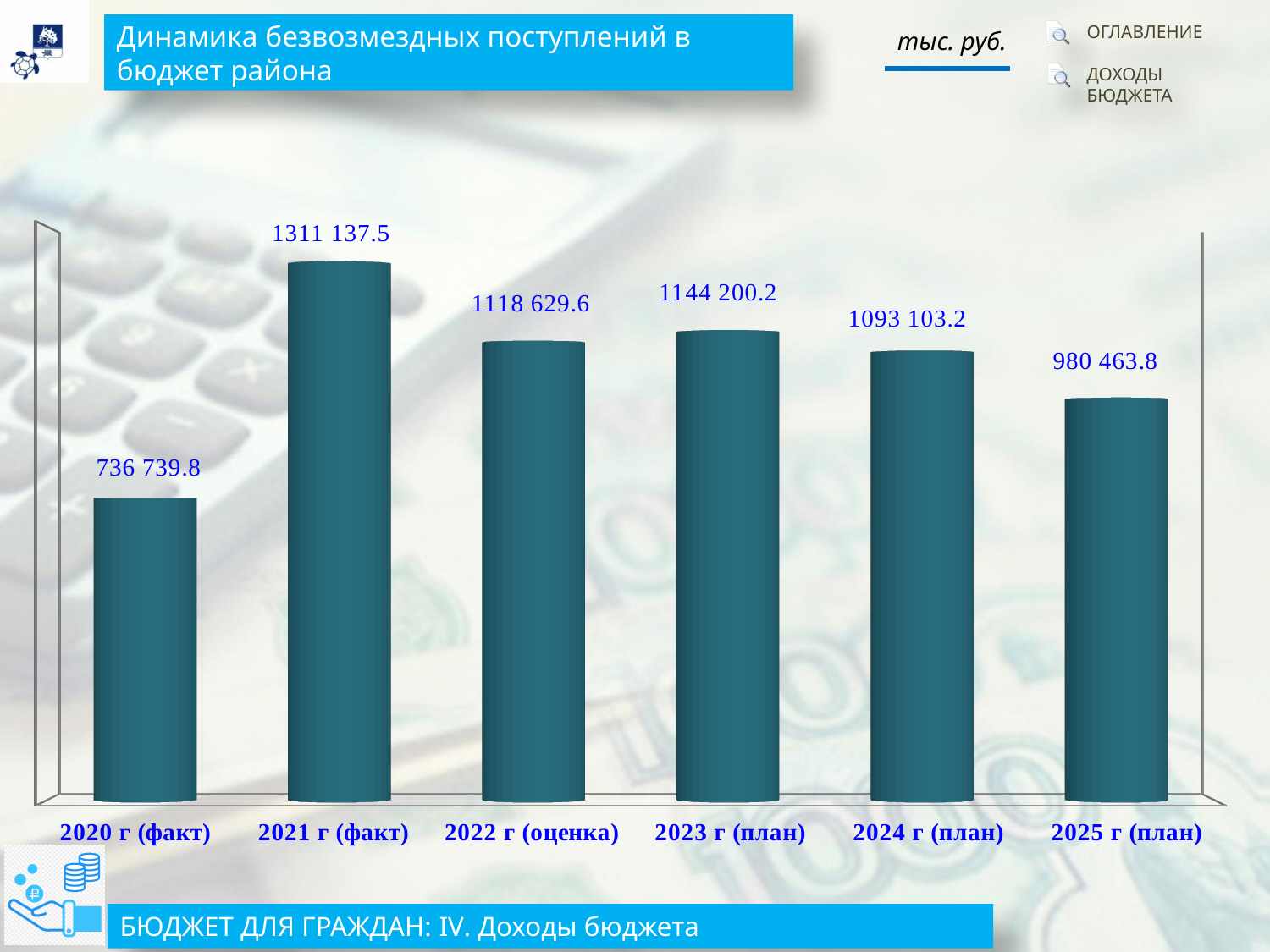
Which category has the lowest value? 2020 г (факт) How many categories are shown on the chart? 6 What is the difference between the values for 2021 г (факт) and 2020 г (факт)? 574 397.7 What unit is indicated for the chart values? тыс. руб. What is the value for 2023 г (план)? 1144 200.2 What kind of chart is shown on the slide? Bar chart What is the value for 2025 г (план)? 980 463.8 What is the difference between the values for 2024 г (план) and 2025 г (план)? 112 639.4 Which is larger, the value for 2022 г (оценка) or the value for 2023 г (план)? 2023 г (план) Which category has the highest value? 2021 г (факт) What is the value for 2020 г (факт)? 736 739.8 Do the values rise or fall from 2023 г (план) to 2025 г (план)? Fall